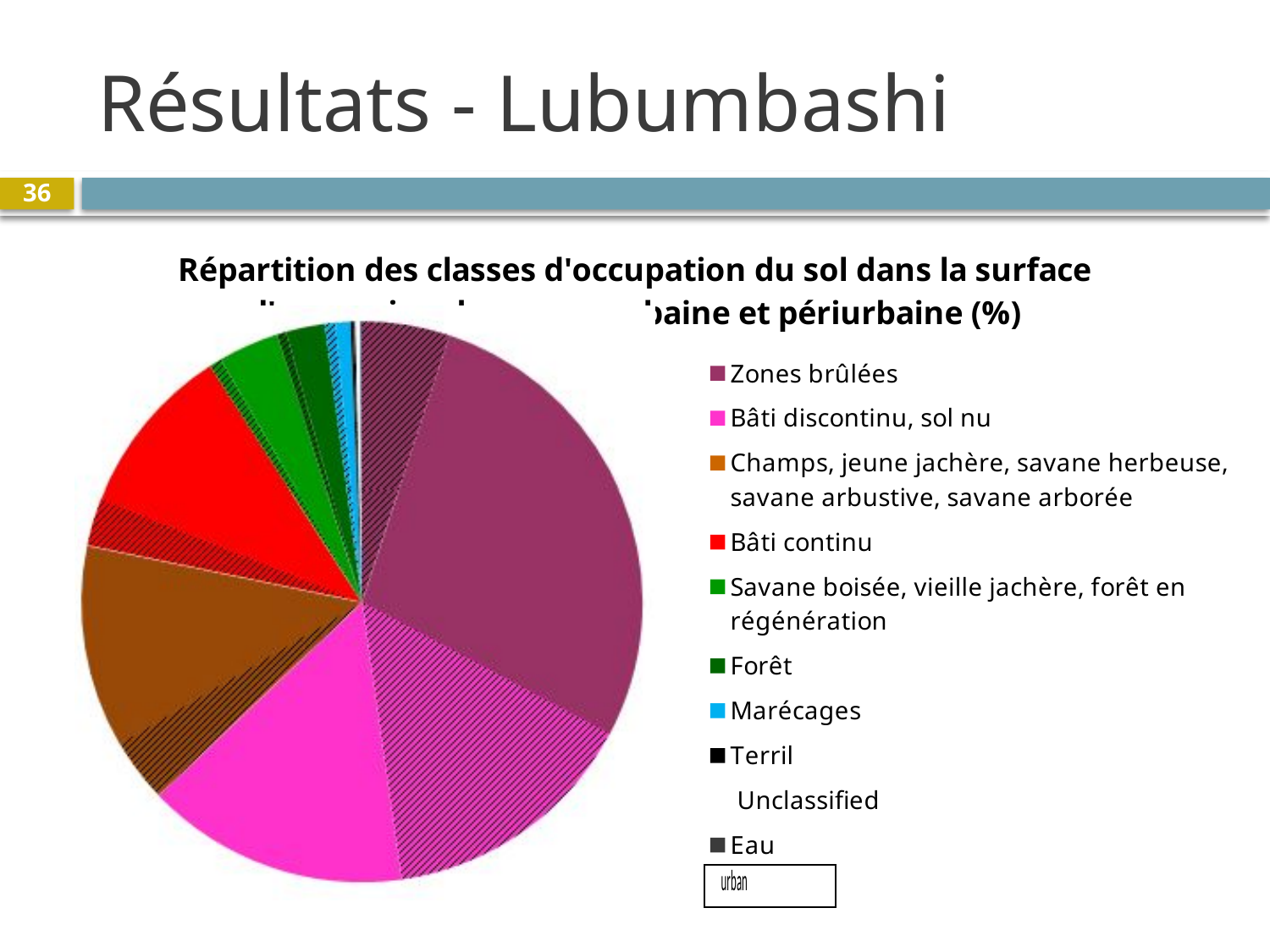
Which has a larger share of the pie: Zones brûlées or Bâti continu? Zones brûlées Which land-cover class has the largest share of the pie chart? Zones brûlées What colour represents Marécages in the pie chart? light blue What kind of chart is shown on the slide? pie chart Which has a larger share of the pie: Champs, jeune jachère, savane herbeuse, savane arbustive, savane arborée or Savane boisée, vieille jachère, forêt en régénération? Champs, jeune jachère, savane herbeuse, savane arbustive, savane arborée What colour represents Bâti continu in the pie chart? red Which has a larger share of the pie: Bâti continu or Forêt? Bâti continu How many entries does the legend of the pie chart list? 10